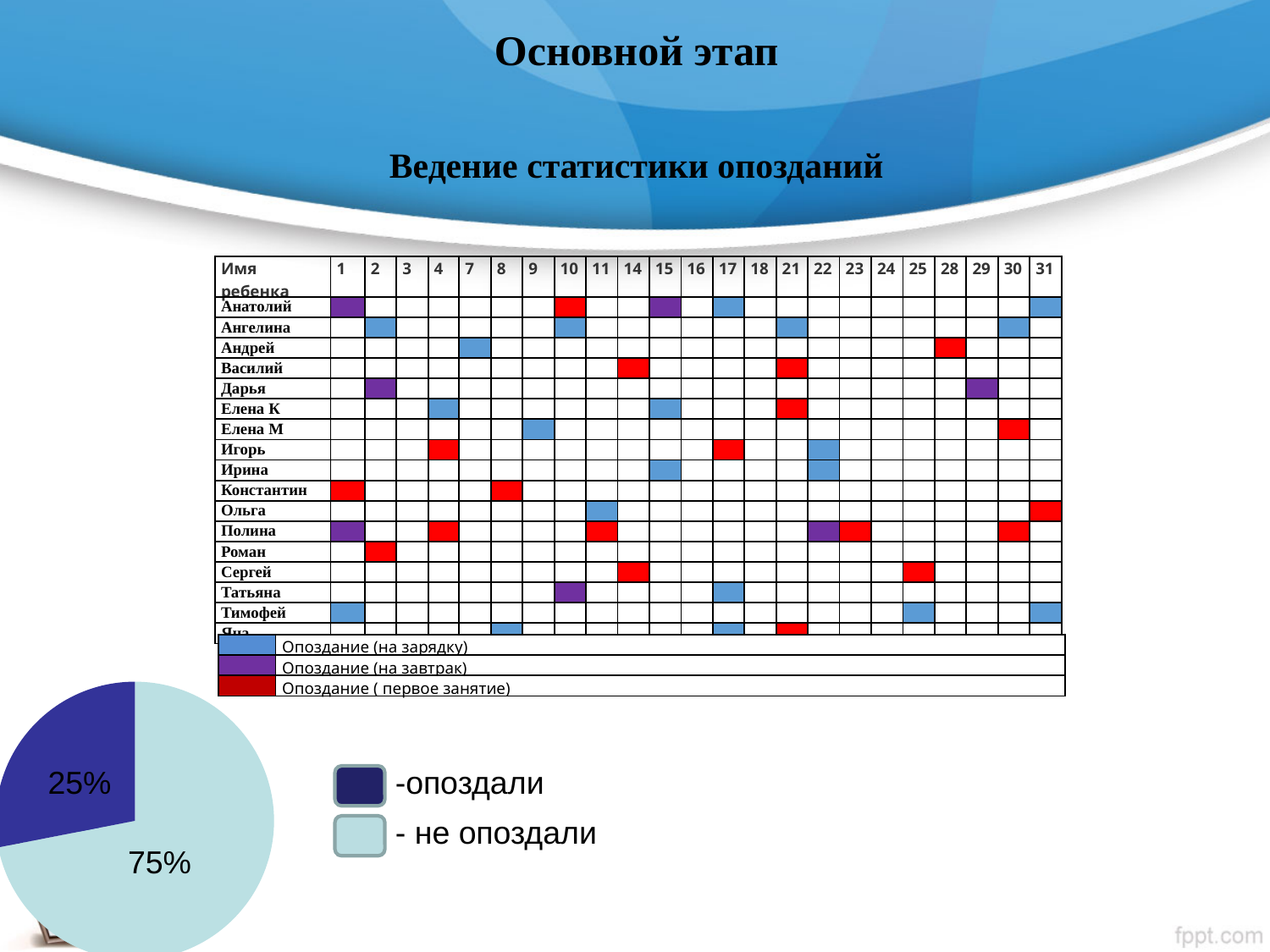
What are the two legend entries of the pie chart? опоздали, не опоздали What kind of chart is shown at the bottom left of the slide? pie chart In the pie chart, which is larger: 'опоздали' or 'не опоздали'? не опоздали What share of the pie chart does the 'опоздали' slice take? 25% How many entries does the legend of the pie chart list? 2 In the pie chart, what is the difference between the 'не опоздали' share and the 'опоздали' share? 50% In the pie chart, what share is labelled for the slice 'опоздали'? 25% Which slice of the pie chart is the smallest? опоздали Which slice of the pie chart is the largest? не опоздали What colour is the 'опоздали' slice in the pie chart? dark blue How many slices does the pie chart have? 2 In the pie chart, what share is labelled for the slice 'не опоздали'? 75%